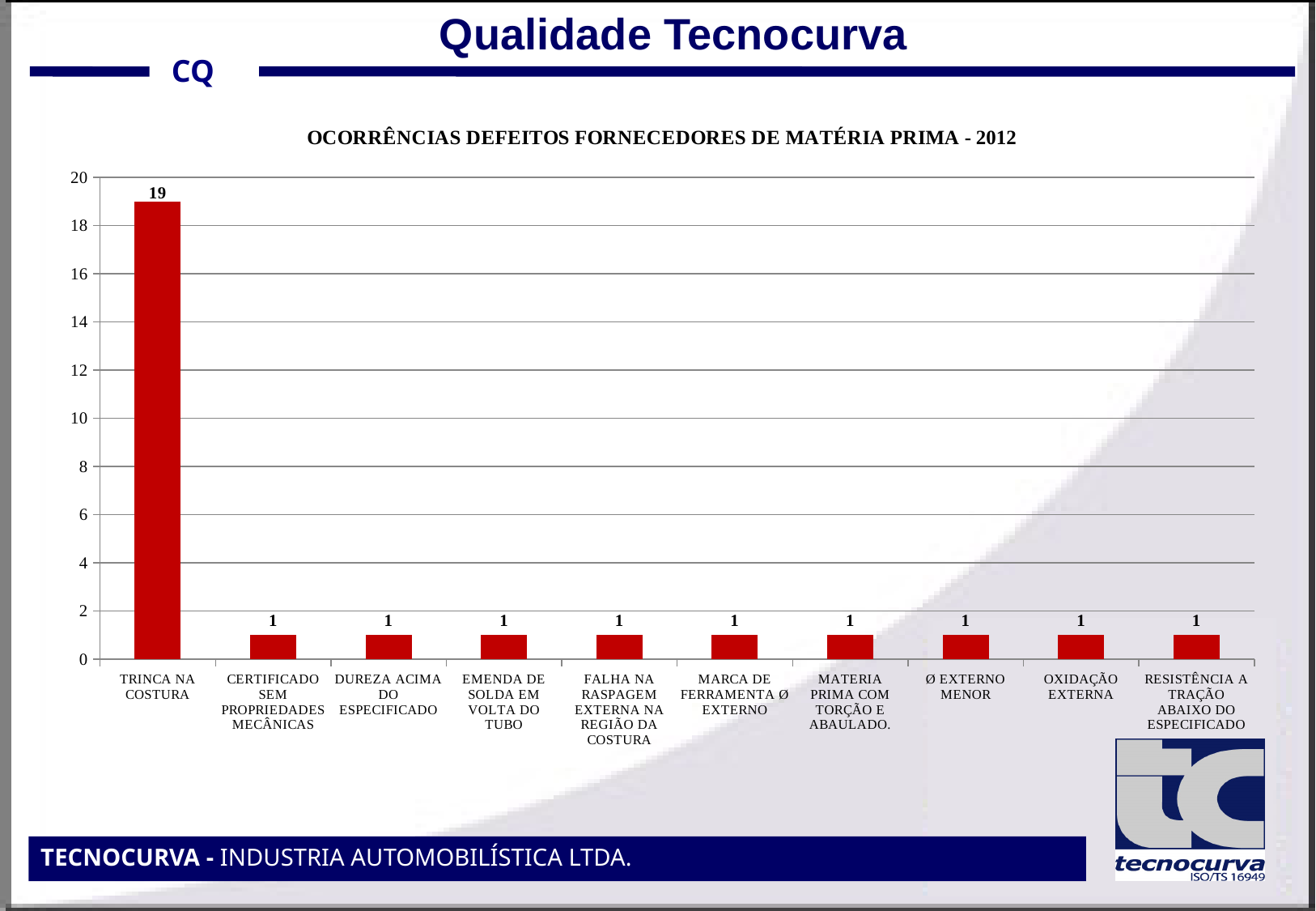
How many categories have a value of 1? 9 What is the value for MARCA DE FERRAMENTA Ø EXTERNO? 1 What colour are the bars in the chart? red What is the value for TRINCA NA COSTURA? 19 What is the title of the chart? OCORRÊNCIAS DEFEITOS FORNECEDORES DE MATÉRIA PRIMA - 2012 Is the value for TRINCA NA COSTURA greater or less than 10? greater What is the difference between the values for TRINCA NA COSTURA and Ø EXTERNO MENOR? 18 Which is larger, the value for TRINCA NA COSTURA or the value for DUREZA ACIMA DO ESPECIFICADO? TRINCA NA COSTURA What kind of chart is shown on the slide? bar chart What is the value for OXIDAÇÃO EXTERNA? 1 Which category has the highest value? TRINCA NA COSTURA How many categories are shown on the x axis? 10